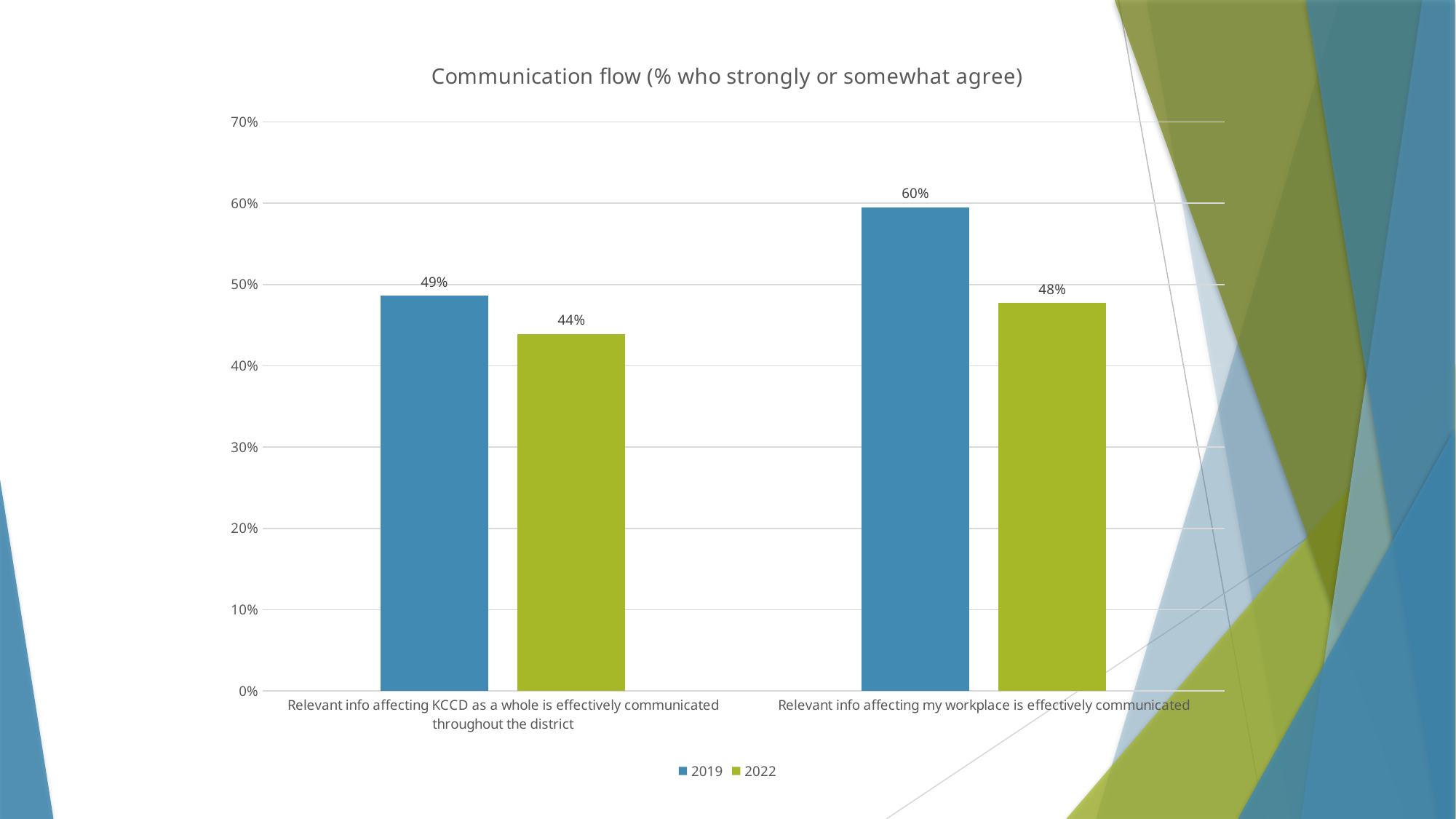
What type of chart is shown on the slide? Bar chart What is the 2022 value for 'Relevant info affecting my workplace is effectively communicated'? 48% What is the 2019 value for 'Relevant info affecting KCCD as a whole is effectively communicated throughout the district'? 49% What is the 2022 value for 'Relevant info affecting KCCD as a whole is effectively communicated throughout the district'? 44% Which bar has the lowest value on the chart? 2022, Relevant info affecting KCCD as a whole is effectively communicated throughout the district What is the difference between the 2019 and 2022 values for 'Relevant info affecting KCCD as a whole is effectively communicated throughout the district'? 5% What is the difference between the 2019 and 2022 values for 'Relevant info affecting my workplace is effectively communicated'? 12% How many series does the legend list? 2 Is the 2019 value for 'Relevant info affecting my workplace is effectively communicated' greater or less than 50%? greater How many categories are shown on the x axis? 2 Which bar has the highest value on the chart? 2019, Relevant info affecting my workplace is effectively communicated Which is larger: the 2019 value for 'Relevant info affecting KCCD as a whole' or the 2019 value for 'Relevant info affecting my workplace'? Relevant info affecting my workplace